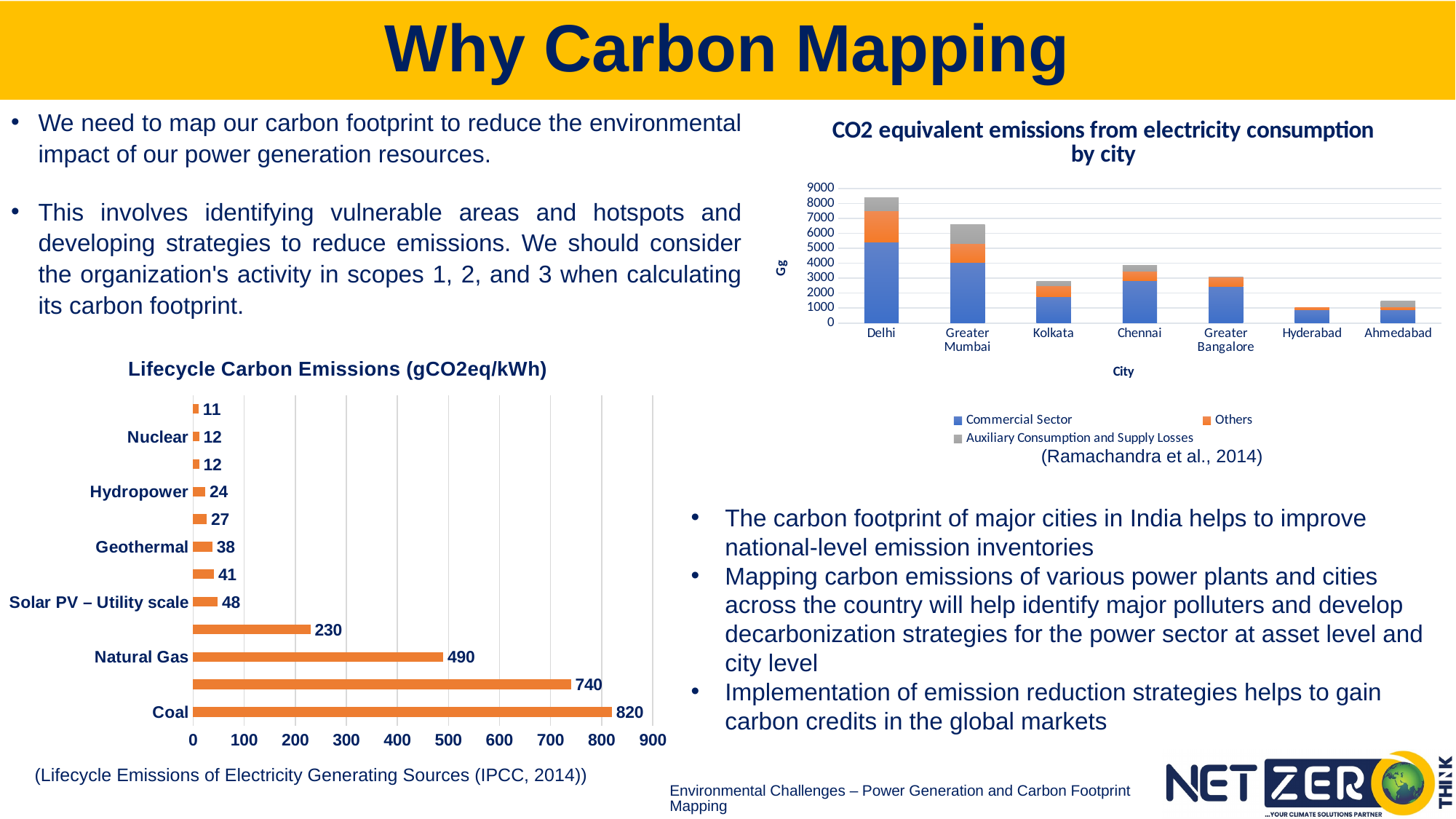
In the CO2 equivalent emissions by city chart, which city has the highest total emissions? Delhi What kind of chart is the Lifecycle Carbon Emissions chart? Bar chart In the Lifecycle Carbon Emissions chart, what is the value for Solar PV – Utility scale? 48 In the CO2 equivalent emissions by city chart, is the total value for Hyderabad greater or less than 2000? less In the Lifecycle Carbon Emissions chart, what is the value for Natural Gas? 490 How many series does the legend of the CO2 equivalent emissions by city chart list? 3 In the Lifecycle Carbon Emissions chart, what is the value for Coal? 820 In the Lifecycle Carbon Emissions chart, what is the value for Hydropower? 24 In the Lifecycle Carbon Emissions chart, which labelled source has the highest value? Coal In the Lifecycle Carbon Emissions chart, which is larger, the value for Geothermal or the value for Nuclear? Geothermal In the Lifecycle Carbon Emissions chart, what is the difference between the values for Coal and Natural Gas? 330 How many bars are plotted in the Lifecycle Carbon Emissions chart? 12